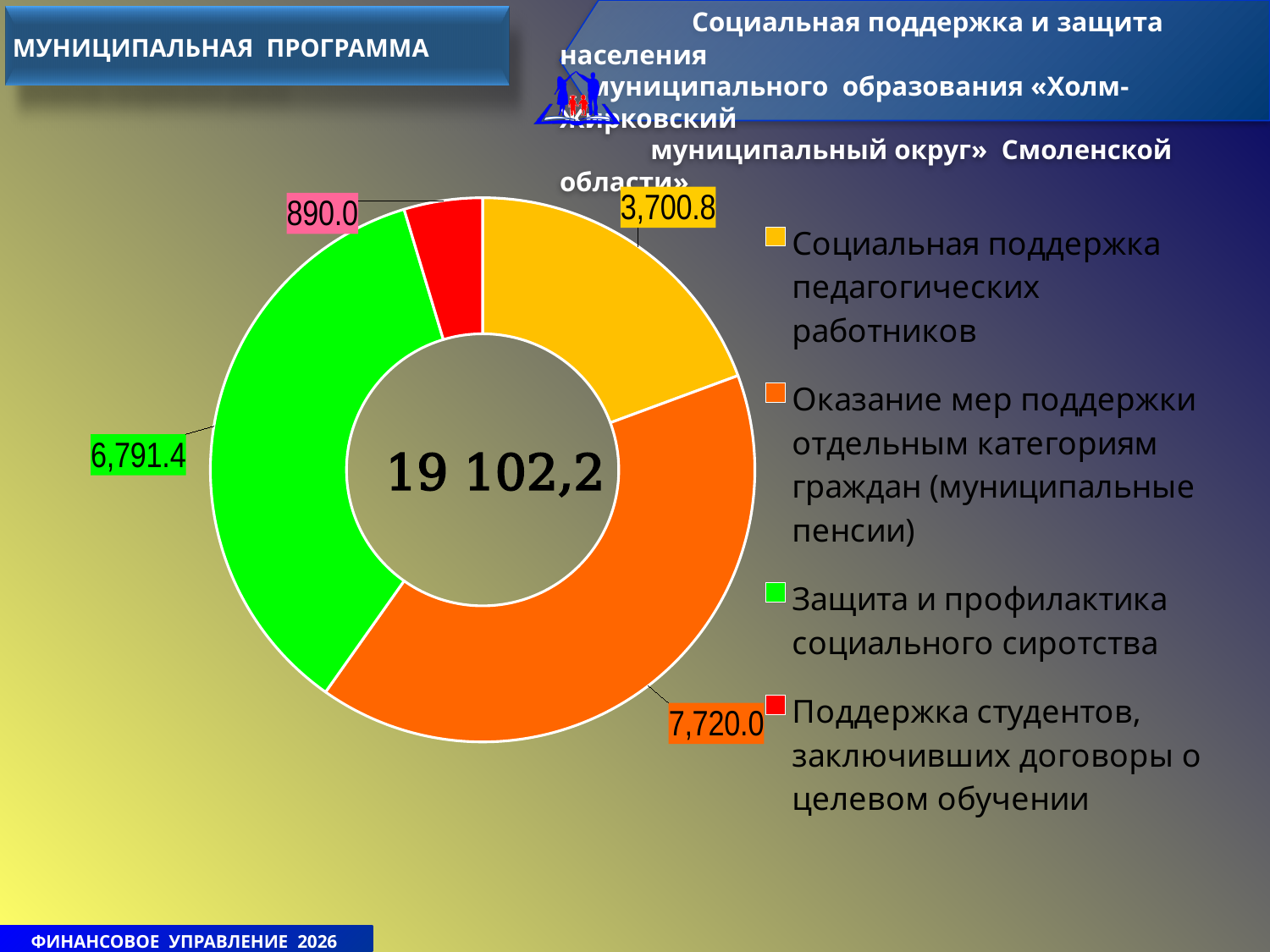
What is the value for «Поддержка студентов, заключивших договоры о целевом обучении»? 890.0 What is the difference between the values for «Оказание мер поддержки отдельным категориям граждан (муниципальные пенсии)» and «Защита и профилактика социального сиротства»? 928.6 What is the value for «Защита и профилактика социального сиротства»? 6,791.4 Which category has the smallest slice? Поддержка студентов, заключивших договоры о целевом обучении What kind of chart is shown on the slide? Pie (doughnut) chart What is the value for «Оказание мер поддержки отдельным категориям граждан (муниципальные пенсии)»? 7,720.0 What is the value for «Социальная поддержка педагогических работников»? 3,700.8 How many categories does the chart show? 4 Which is larger: «Социальная поддержка педагогических работников» or «Защита и профилактика социального сиротства»? Защита и профилактика социального сиротства What total is printed in the centre of the chart? 19 102,2 Which category has the largest slice? Оказание мер поддержки отдельным категориям граждан (муниципальные пенсии) What colour is the slice for «Защита и профилактика социального сиротства»? Green